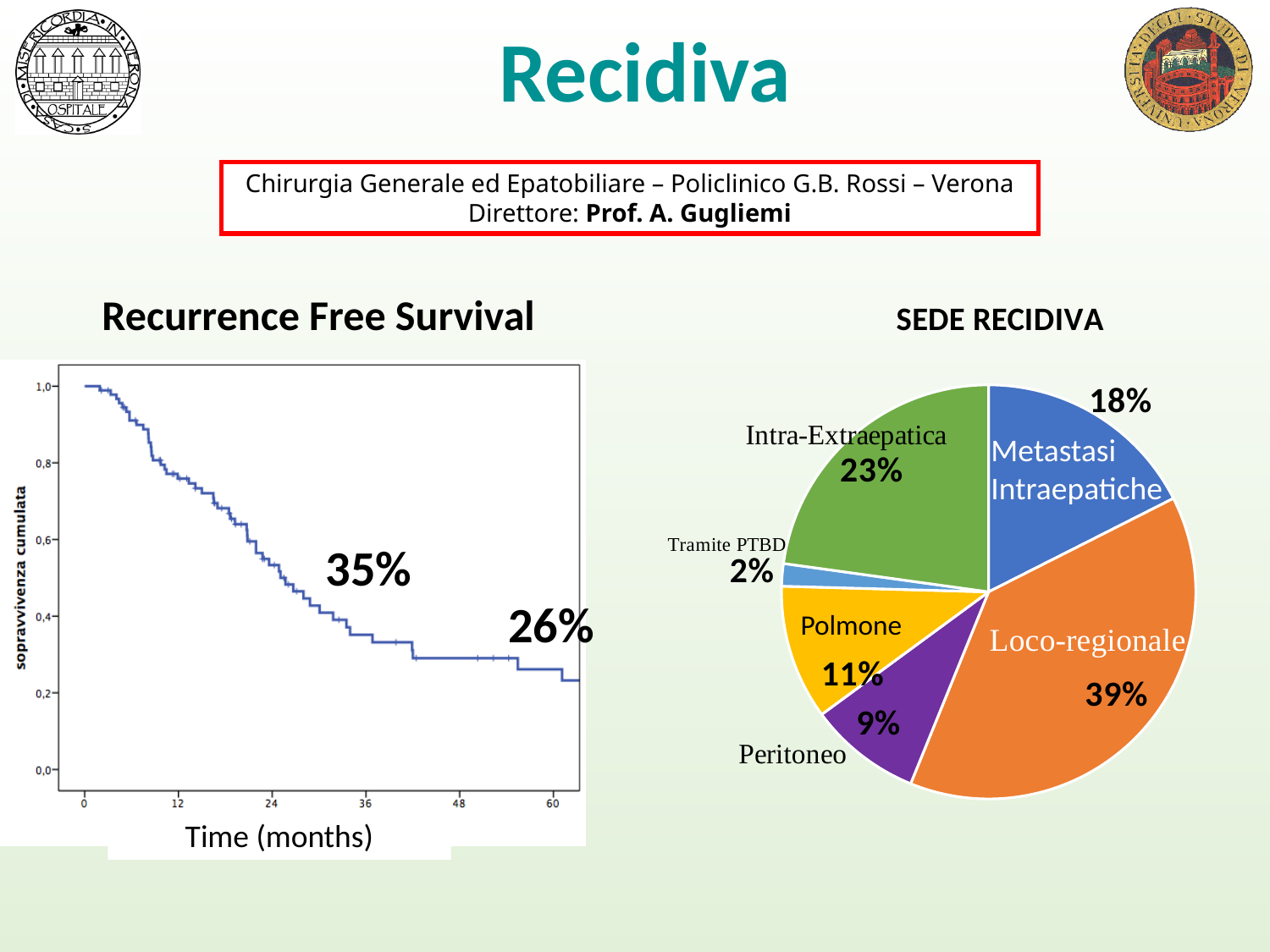
In the SEDE RECIDIVA pie chart, what percentage is Metastasi Intraepatiche? 18% In the SEDE RECIDIVA pie chart, which site has the smallest share? Tramite PTBD How many slices does the SEDE RECIDIVA pie chart have? 6 In the SEDE RECIDIVA pie chart, what is the difference between the Loco-regionale and Intra-Extraepatica percentages? 16% What kind of chart is the SEDE RECIDIVA chart? Pie chart In the SEDE RECIDIVA pie chart, which is larger, Polmone or Peritoneo? Polmone What is the x-axis label of the Recurrence Free Survival chart? Time (months) In the Recurrence Free Survival chart, what two percentage values are annotated on the curve? 35% and 26% In the SEDE RECIDIVA pie chart, which site has the largest share? Loco-regionale In the SEDE RECIDIVA pie chart, what percentage is Loco-regionale? 39% In the SEDE RECIDIVA pie chart, what share does Tramite PTBD have? 2% In the Recurrence Free Survival chart, does the curve rise or fall as time increases? Fall